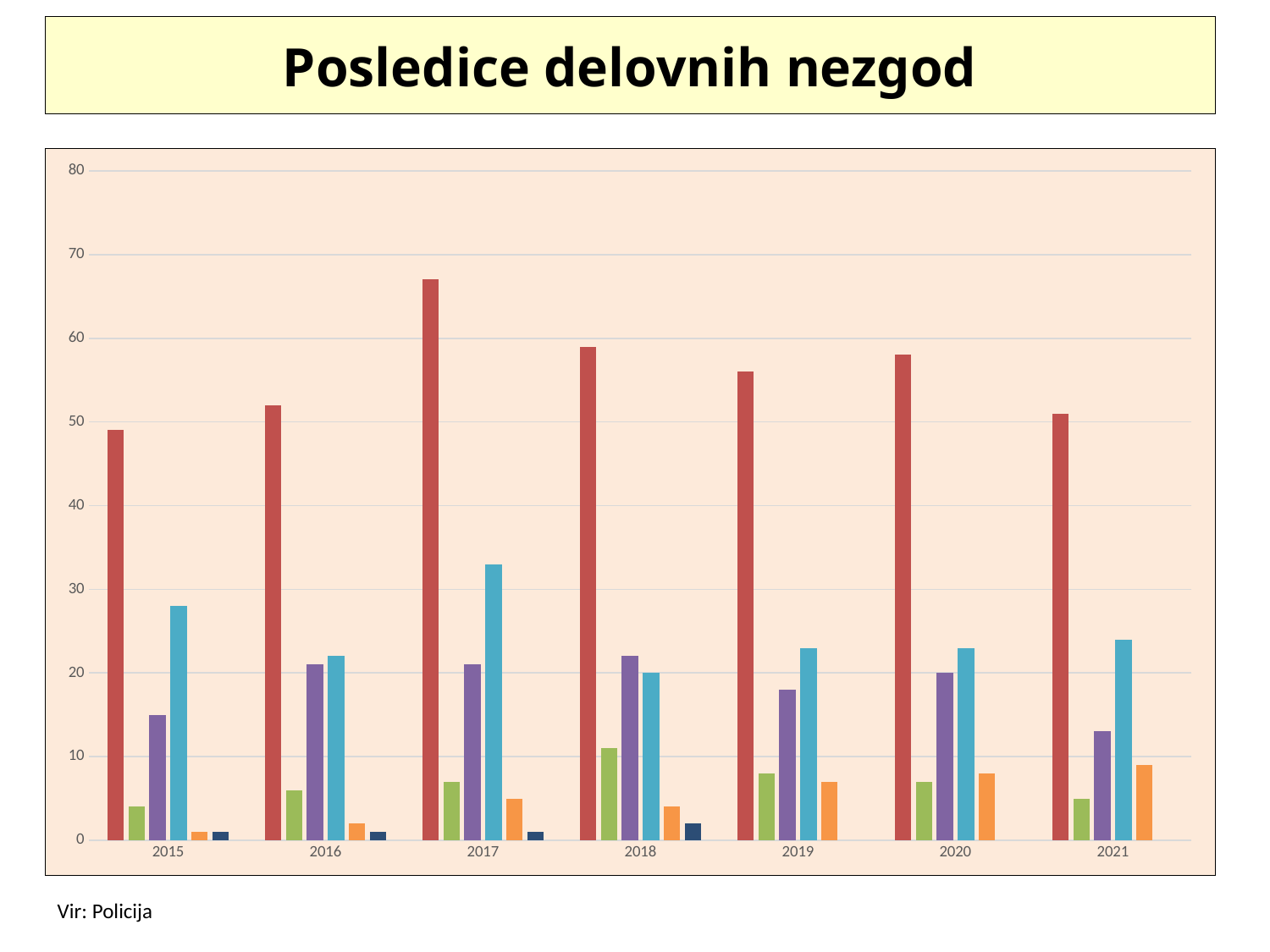
Is the value of the purple bar for 2015 greater or less than 20? less In which year is the red bar the highest? 2017 Is the value of the light blue bar for 2017 greater or less than 30? greater Is the value of the red bar for 2017 greater or less than 60? greater Which is larger, the red bar for 2018 or the red bar for 2021? 2018 What is the title of the slide? Posledice delovnih nezgod What source is cited below the chart? Vir: Policija In which year is the light blue bar the highest? 2017 How many years are shown on the x axis of the chart? 7 What kind of chart is shown on the slide? bar chart